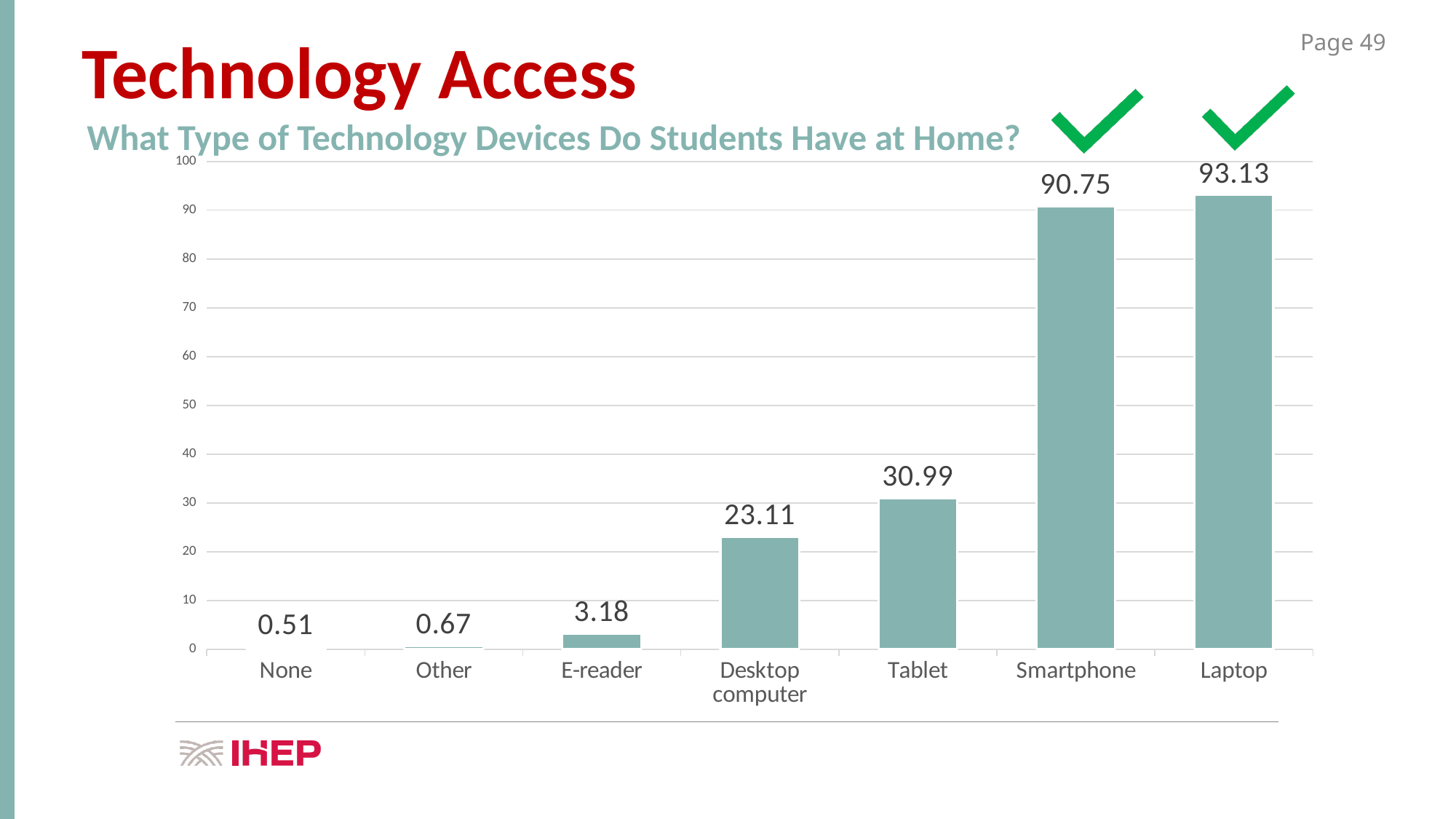
Which is larger, the value for Tablet or the value for Desktop computer? Tablet What kind of chart is shown on the slide? bar chart What is the value for Desktop computer? 23.11 What is the value for E-reader? 3.18 Which category has the highest value? Laptop How many categories are shown on the x axis? 7 Which category has the lowest value? None What is the difference between the values for Tablet and Desktop computer? 7.88 What is the value for Smartphone? 90.75 What is the subtitle question shown above the chart? What Type of Technology Devices Do Students Have at Home? Is the value for Tablet greater or less than 40? less What is the difference between the values for Laptop and Smartphone? 2.38